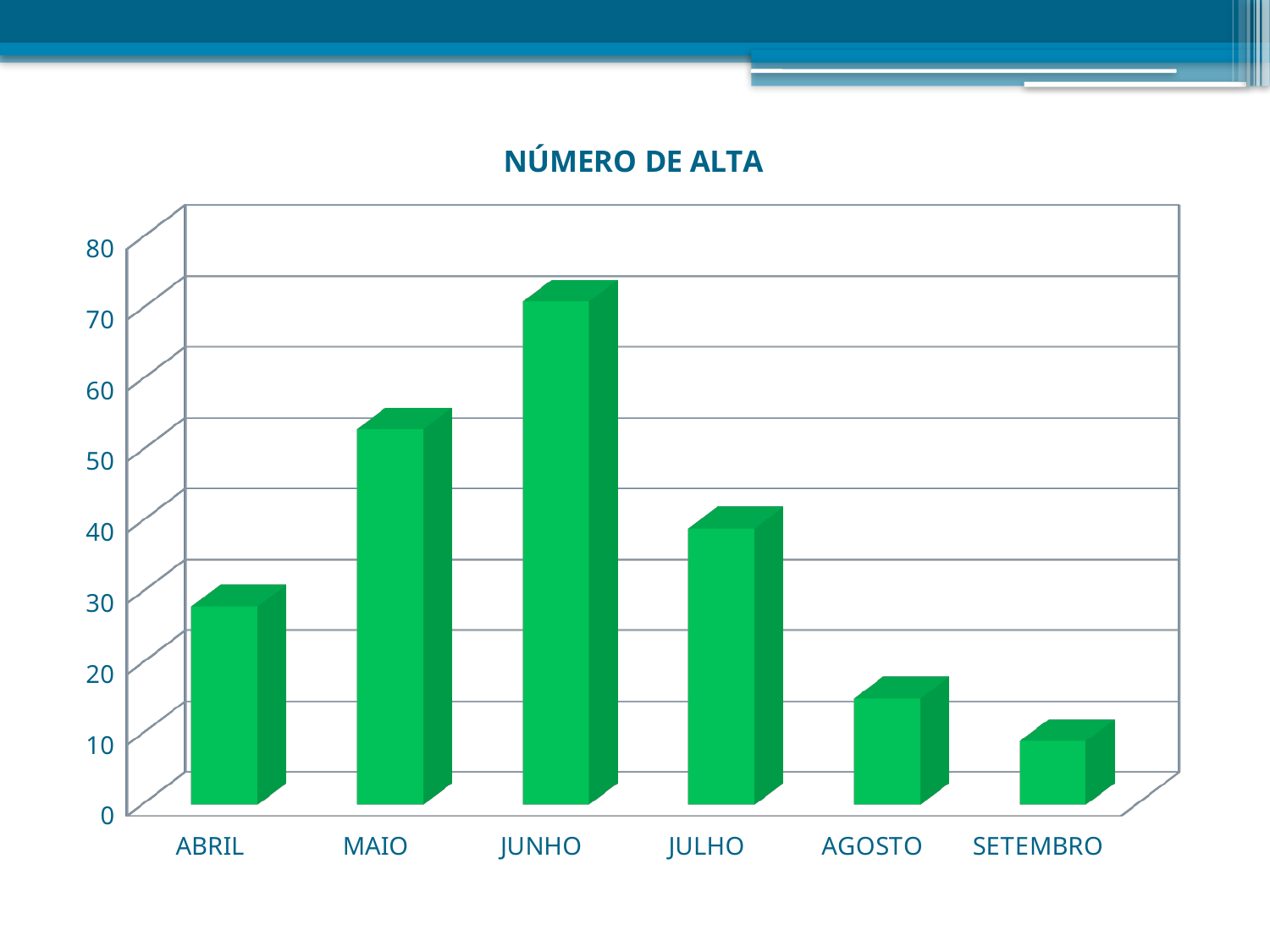
What is the title of the chart? NÚMERO DE ALTA What kind of chart is shown on the slide? Bar chart Is the value for MAIO greater or less than 50? greater Is the value for JUNHO greater or less than 60? greater Is the value for AGOSTO greater or less than 20? less Which month has the lowest value in the chart? SETEMBRO What colour are the bars in the chart? Green How many months are shown on the x axis of the chart? 6 Which is larger, the value for MAIO or the value for JULHO? MAIO Which month has the highest value in the chart? JUNHO Do the values rise or fall from JUNHO to SETEMBRO? fall